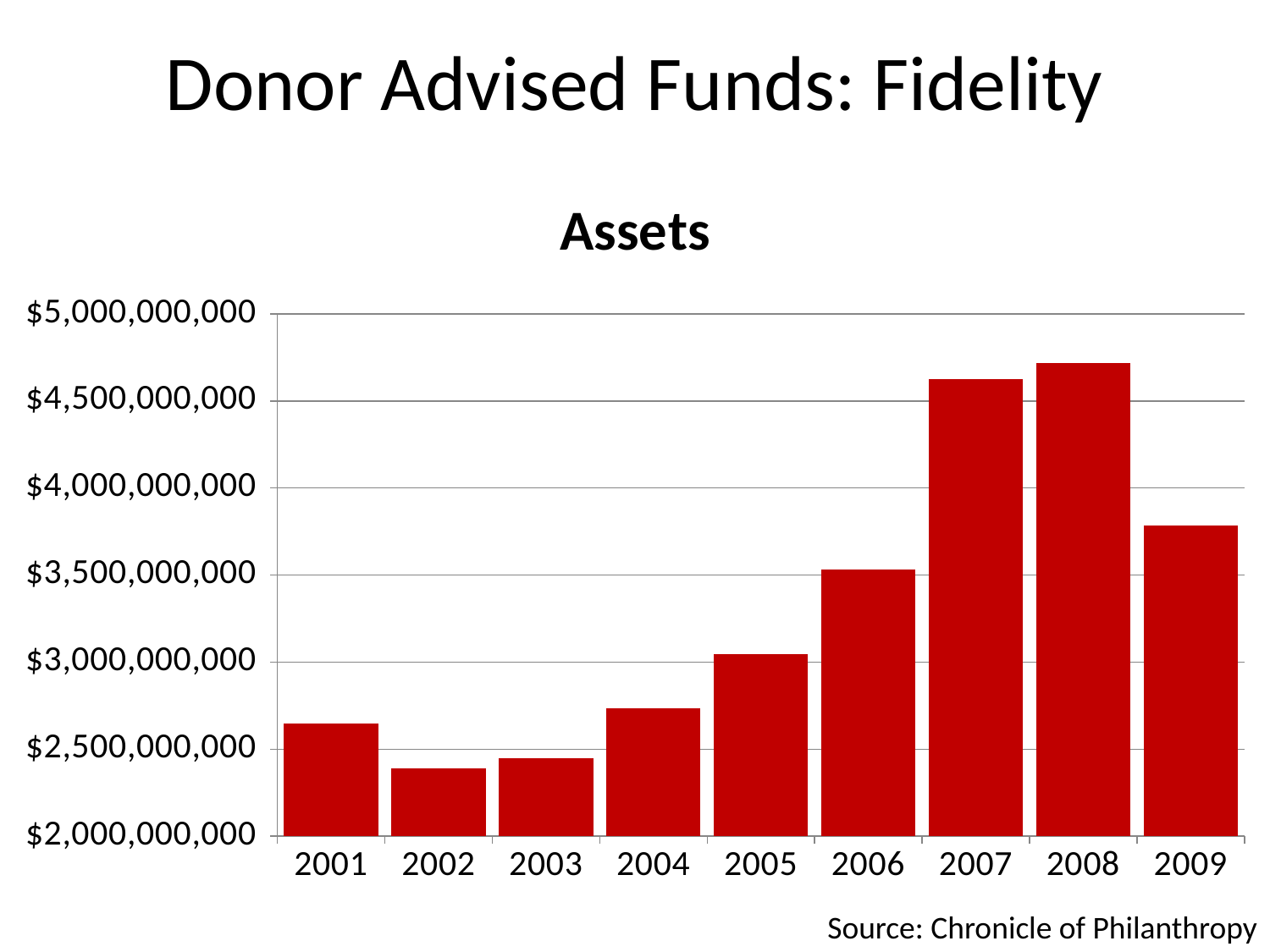
Do the assets values rise or fall from 2003 to 2008? rise Which year has the highest assets value? 2008 Which year has a larger assets value, 2006 or 2009? 2009 Which year has the lowest assets value? 2002 Is the assets value for 2004 greater or less than $3,000,000,000? less What is the source cited for the chart data? Chronicle of Philanthropy How many years are shown on the x axis of the Assets chart? 9 Is the assets value for 2002 greater or less than $2,500,000,000? less Is the assets value for 2007 greater or less than $4,500,000,000? greater What kind of chart is shown on the slide? bar chart